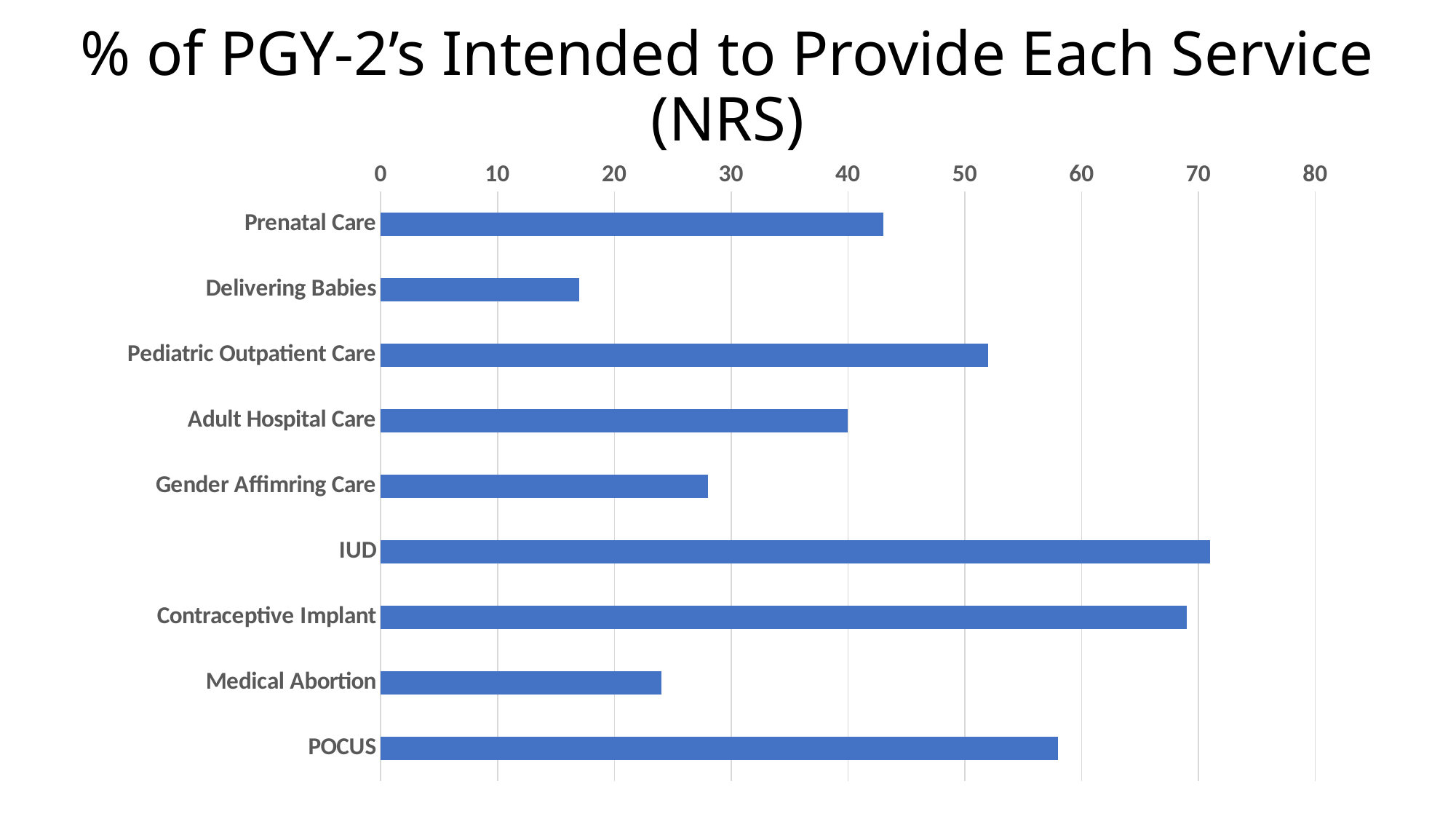
Is the value for Delivering Babies greater or less than 20? less Is the value for Medical Abortion greater or less than 30? less Which is larger, the value for Medical Abortion or the value for Contraceptive Implant? Contraceptive Implant What is the title of the chart? % of PGY-2's Intended to Provide Each Service (NRS) Is the value for Pediatric Outpatient Care greater or less than 50? greater What kind of chart is shown on the slide? bar chart How many services (categories) are shown in the chart? 9 Which is larger, the value for Pediatric Outpatient Care or the value for Gender Affimring Care? Pediatric Outpatient Care Which service has the highest percentage of PGY-2's intending to provide it? IUD Which service has the lowest percentage of PGY-2's intending to provide it? Delivering Babies